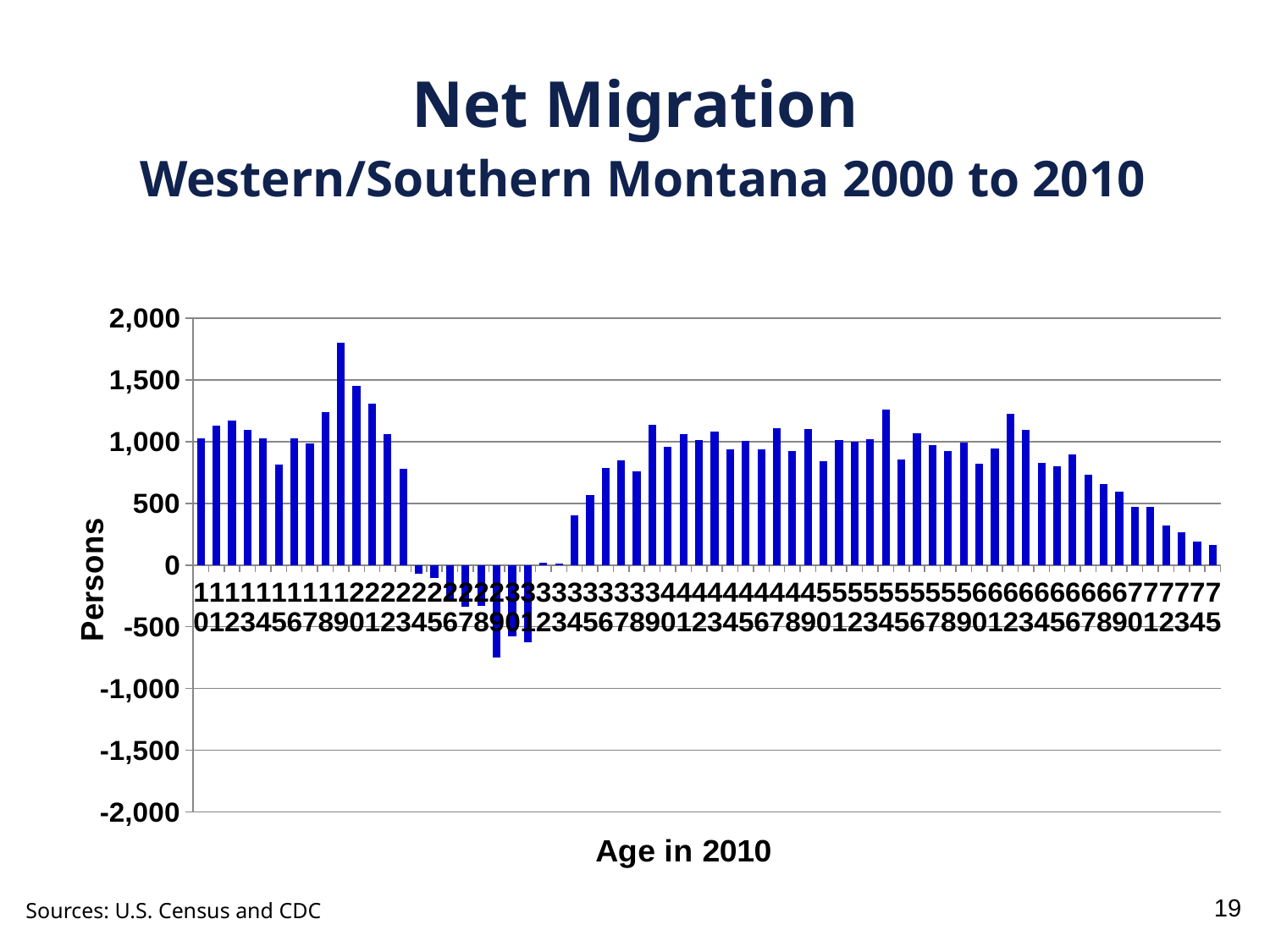
Is the value for age 22 greater or less than 1,500? less What kind of chart is shown on the slide? Bar chart Is the value for age 29 greater or less than -500? less Which age has the highest net migration value? 19 Which age has the lowest net migration value? 29 Do the values rise or fall from age 65 to age 75? Fall Is the value for age 74 greater or less than 500? less Which is larger, the value for age 20 or the value for age 21? Age 20 What is the title of the vertical axis? Persons Which is larger, the value for age 55 or the value for age 54? Age 54